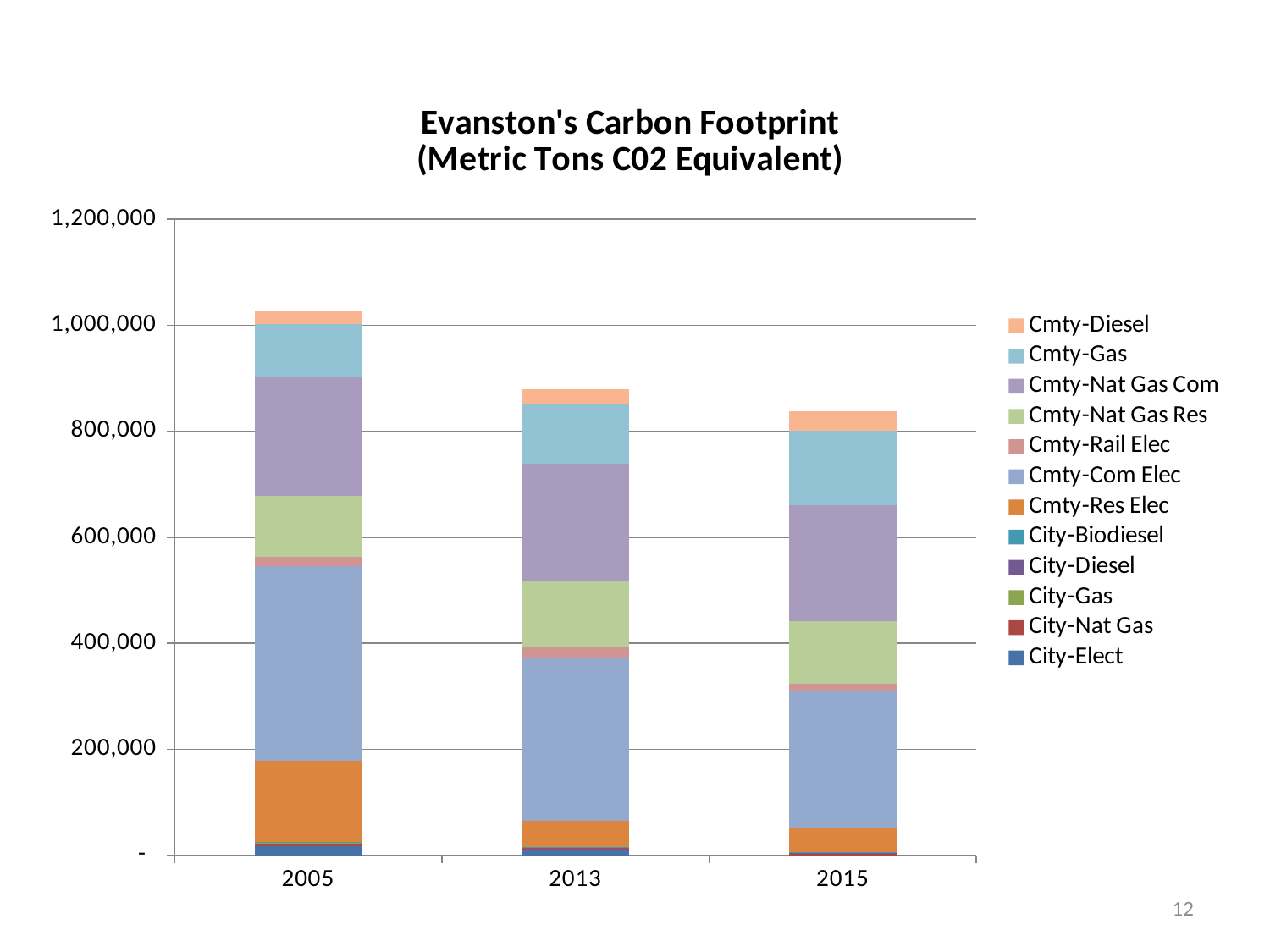
What kind of chart is shown on the slide? Stacked bar chart Which year has the highest total carbon footprint? 2005 Is the total carbon footprint for 2013 greater or less than 800,000? greater Which year has the larger total carbon footprint, 2005 or 2015? 2005 How many series does the legend list? 12 Do the total carbon footprint values rise or fall from 2005 to 2015? fall How many years are shown on the x axis of the chart? 3 Is the total carbon footprint for 2013 greater or less than 1,000,000? less Is the total carbon footprint for 2005 greater or less than 1,000,000? greater Which series is listed first in the legend? Cmty-Diesel What is the title of the chart? Evanston's Carbon Footprint (Metric Tons C02 Equivalent)